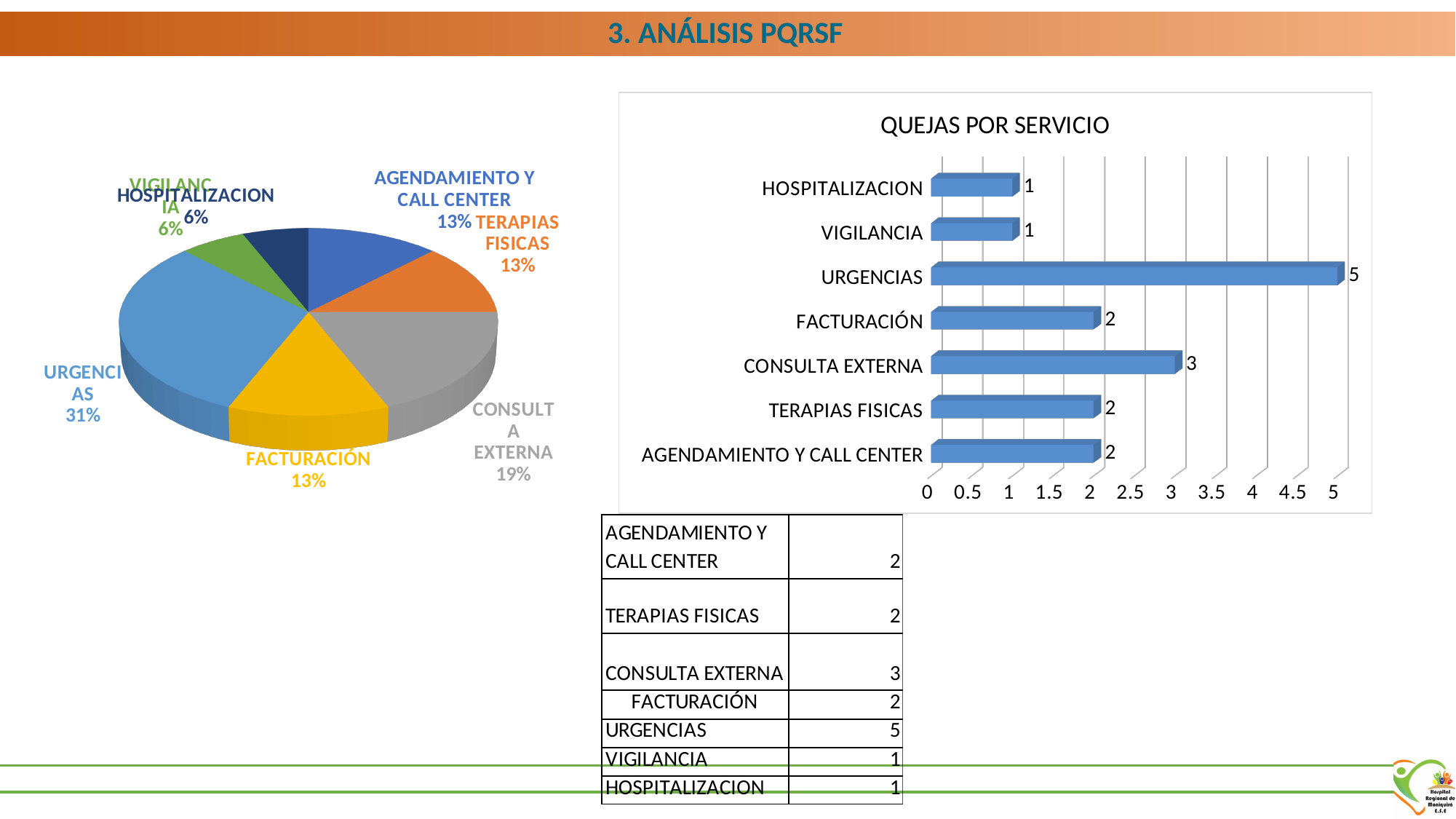
In the pie chart on the left of the slide, what share does HOSPITALIZACION have? 6% In the bar chart titled QUEJAS POR SERVICIO, which category has the highest value? URGENCIAS In the bar chart titled QUEJAS POR SERVICIO, what is the difference between the values for URGENCIAS and CONSULTA EXTERNA? 2 In the bar chart titled QUEJAS POR SERVICIO, which is larger, the value for FACTURACIÓN or the value for VIGILANCIA? FACTURACIÓN In the pie chart on the left of the slide, which category has the largest slice? URGENCIAS In the pie chart on the left of the slide, what share does URGENCIAS have? 31% In the bar chart titled QUEJAS POR SERVICIO, what is the value for CONSULTA EXTERNA? 3 In the bar chart titled QUEJAS POR SERVICIO, how many categories are shown? 7 In the pie chart on the left of the slide, what share does CONSULTA EXTERNA have? 19% In the bar chart titled QUEJAS POR SERVICIO, what is the value for URGENCIAS? 5 What kind of chart is the chart titled QUEJAS POR SERVICIO? Bar chart What is the title of the bar chart on the right of the slide? QUEJAS POR SERVICIO